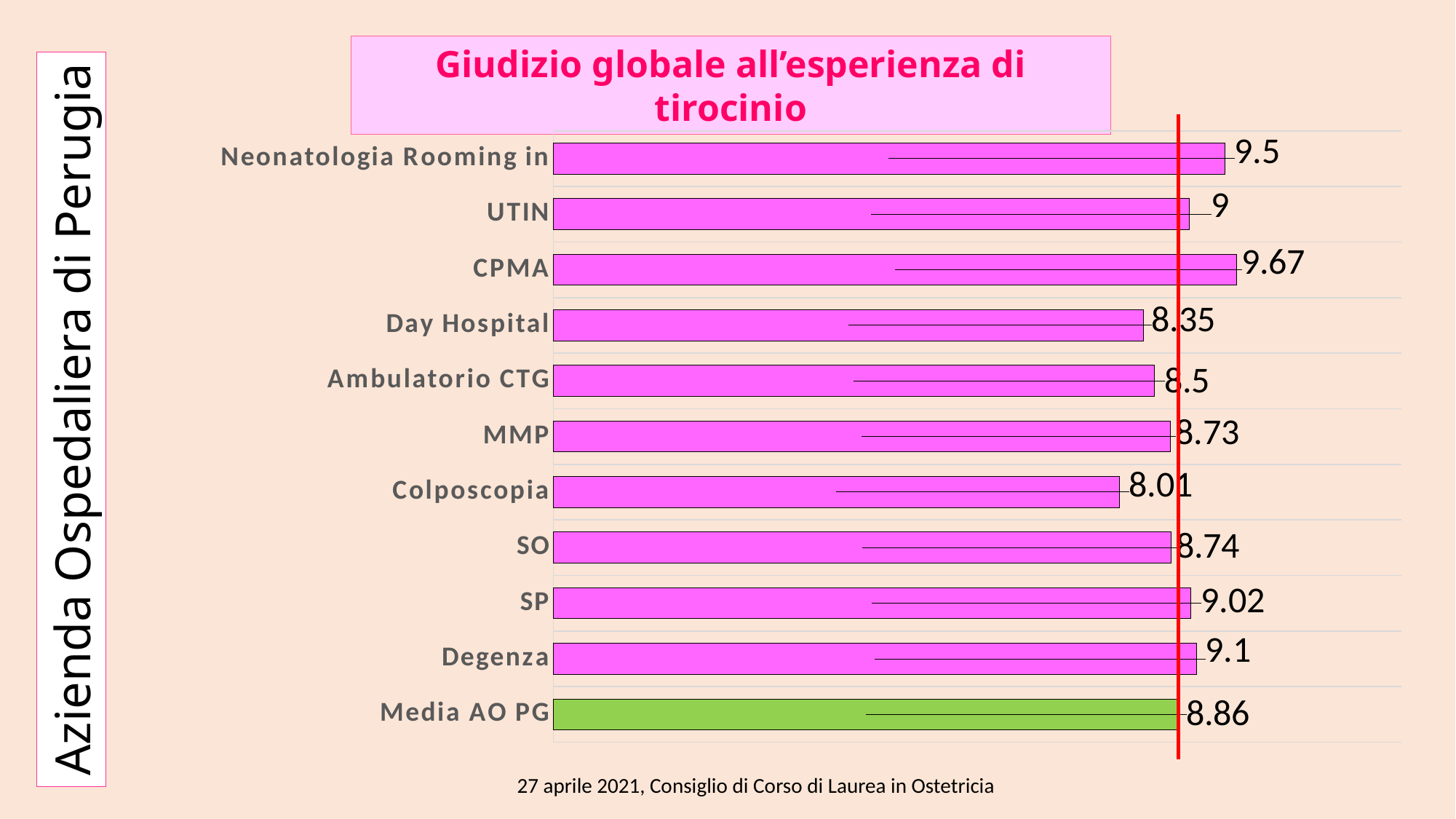
What is the difference between the values for Neonatologia Rooming in and UTIN? 0.5 What is the value for Colposcopia? 8.01 Which is larger, the value for Degenza or the value for SP? Degenza What kind of chart is shown on the slide? Bar chart What is the value for Day Hospital? 8.35 What is the value for CPMA? 9.67 What is the title of the chart? Giudizio globale all'esperienza di tirocinio Which category has the lowest value? Colposcopia How many categories are shown in the chart? 11 What is the value for Media AO PG? 8.86 Which category has the highest value? CPMA Which category's bar is coloured green rather than pink? Media AO PG